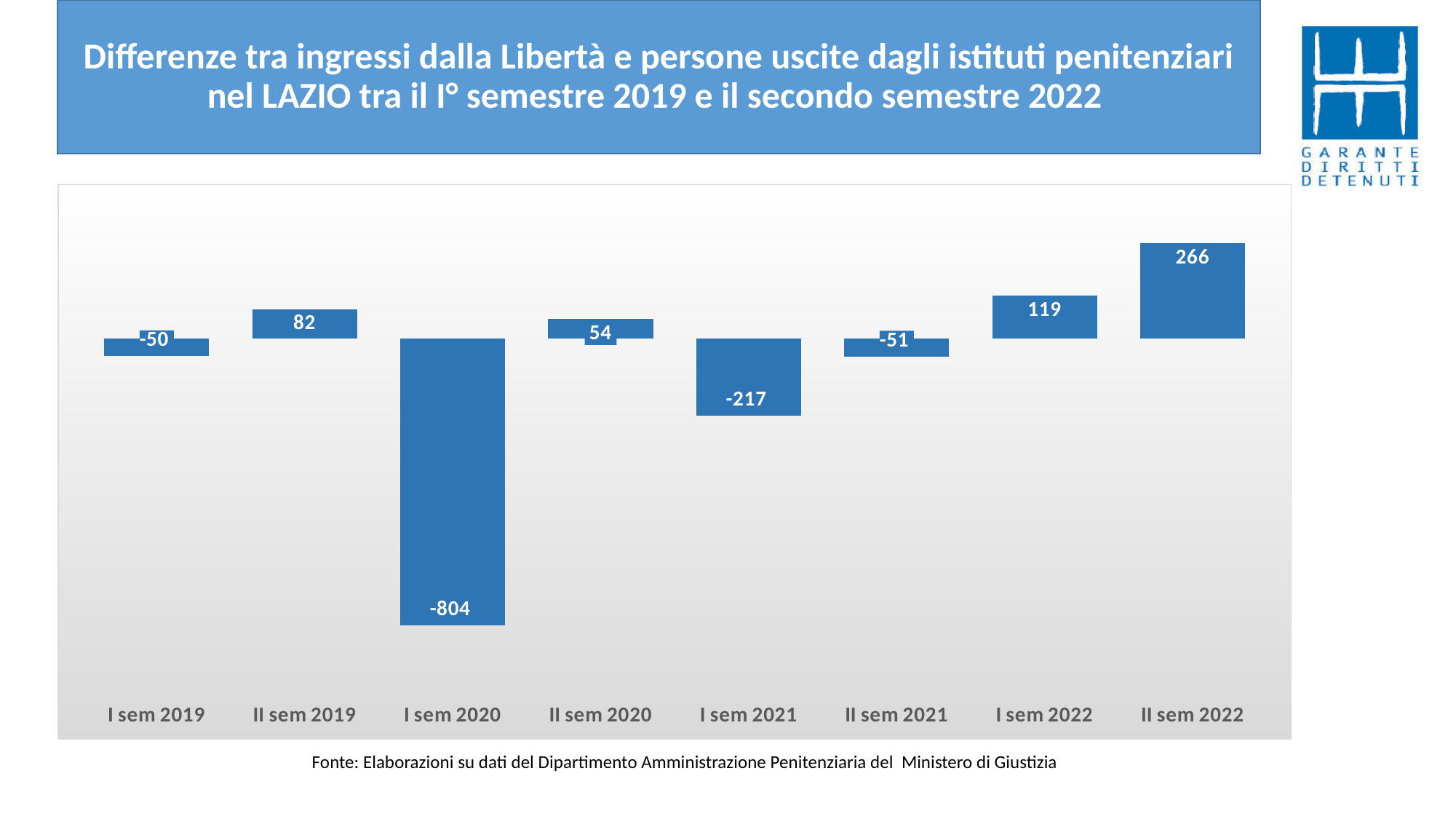
What is the value for II sem 2019? 82 What is the source cited below the chart? Elaborazioni su dati del Dipartimento Amministrazione Penitenziaria del Ministero di Giustizia What kind of chart is shown on the slide? Bar chart Which semester has the lowest value? I sem 2020 Do the values rise or fall from II sem 2021 to II sem 2022? Rise Which is larger, the value for II sem 2019 or the value for II sem 2020? II sem 2019 Which semester has the highest value? II sem 2022 What is the difference between the values for II sem 2022 and I sem 2022? 147 How many semesters are shown on the x axis? 8 What is the value for II sem 2022? 266 What is the value for I sem 2021? -217 What is the value for I sem 2020? -804